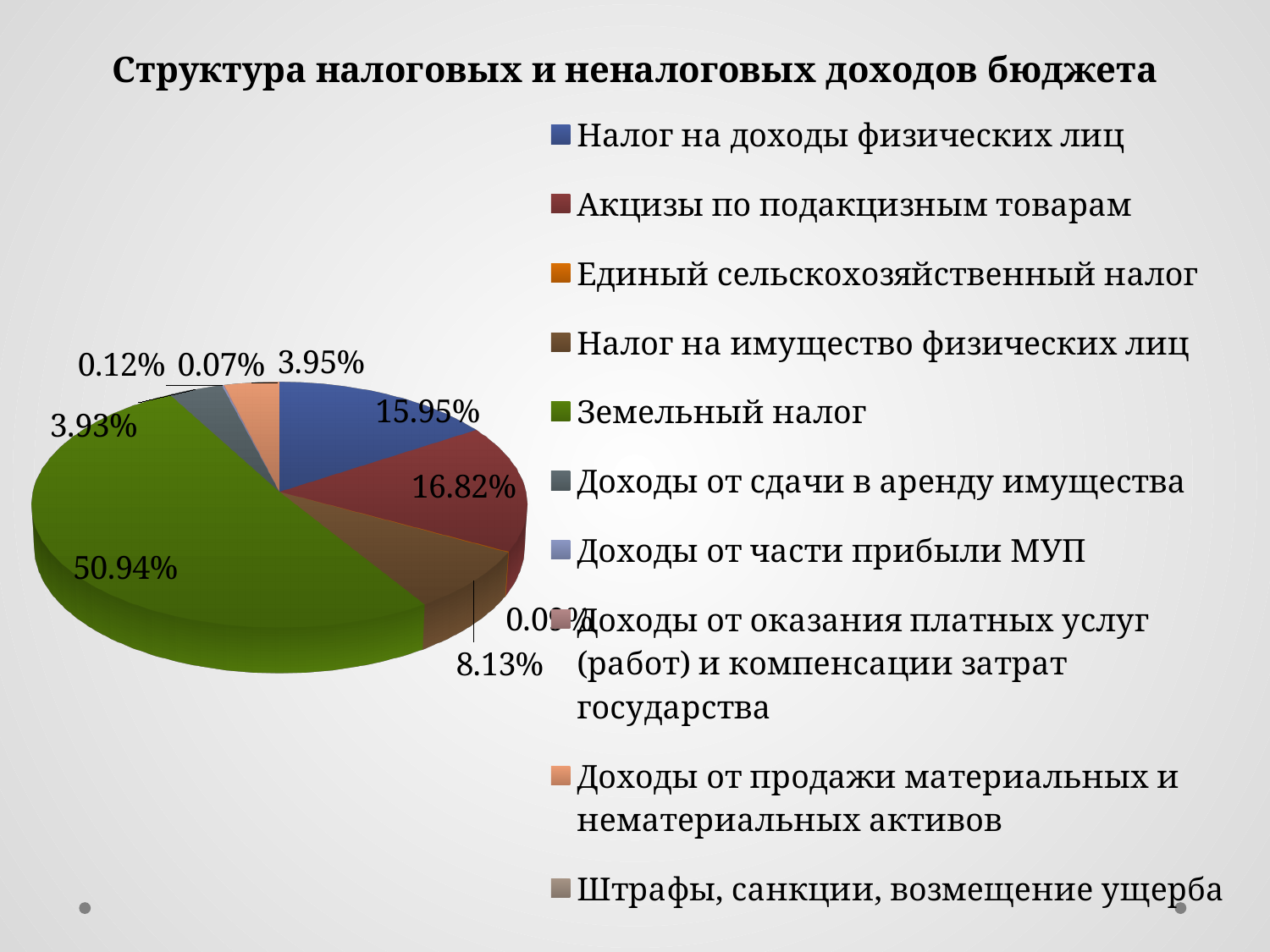
Which category has the largest share of the pie? Земельный налог What is the value shown for Акцизы по подакцизным товарам? 16.82% What is the value shown for Налог на имущество физических лиц? 8.13% What is the value shown for Налог на доходы физических лиц? 15.95% What is the title of the chart? Структура налоговых и неналоговых доходов бюджета Which is larger: the share for Акцизы по подакцизным товарам or for Налог на доходы физических лиц? Акцизы по подакцизным товарам What share of the pie does Земельный налог have? 50.94% How many entries does the chart legend list? 10 What kind of chart is shown on the slide? pie chart What is the value shown for Доходы от сдачи в аренду имущества? 3.93% What colour is the slice for Земельный налог? green What is the difference between the shares of Акцизы по подакцизным товарам and Налог на доходы физических лиц? 0.87%